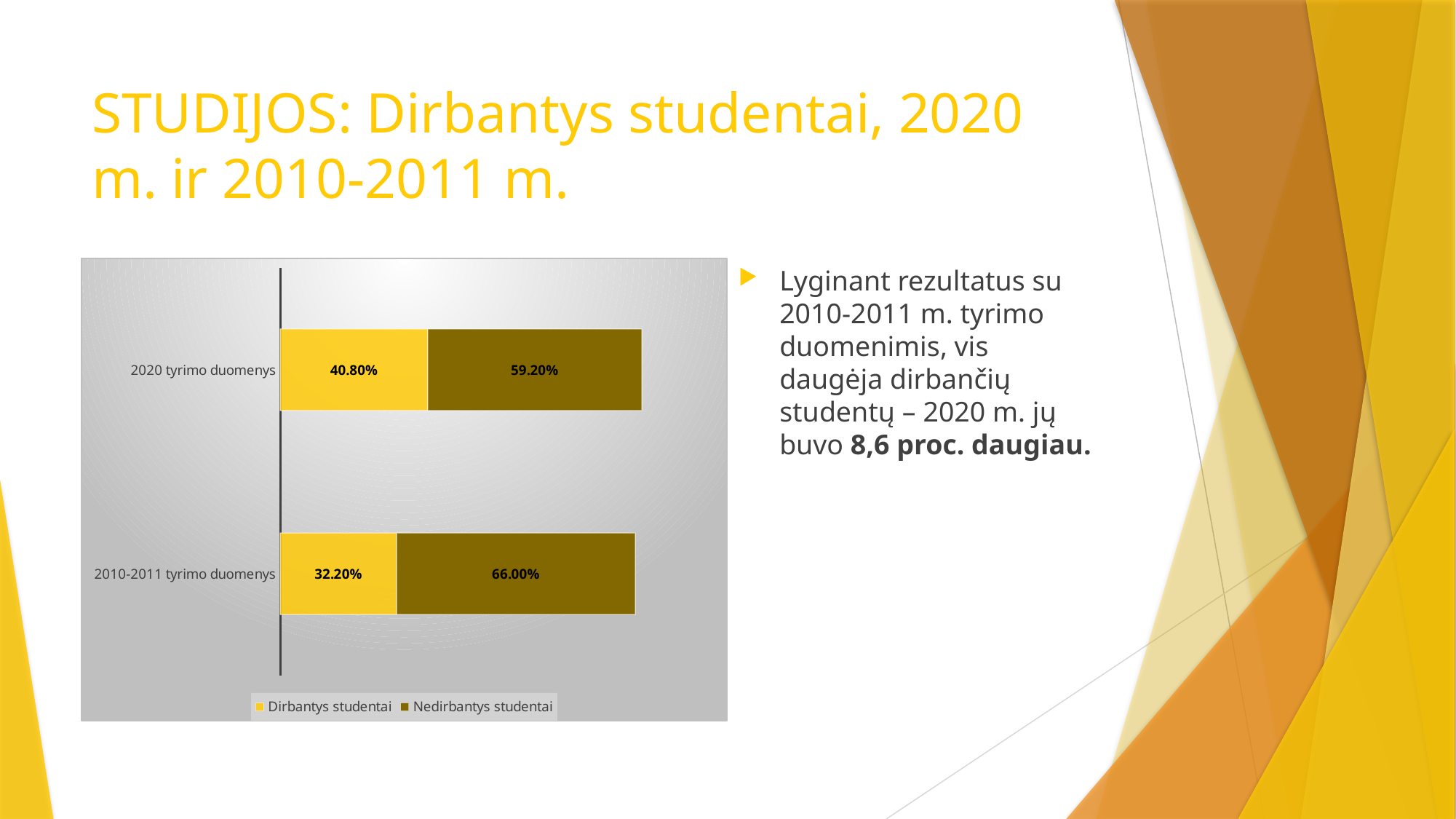
Which category has the higher value for Dirbantys studentai? 2020 tyrimo duomenys Which category has the lower value for Nedirbantys studentai? 2020 tyrimo duomenys What is the value for Dirbantys studentai in 2010-2011 tyrimo duomenys? 32.20% How many series does the legend list? 2 What is the value for Dirbantys studentai in 2020 tyrimo duomenys? 40.80% How many categories are shown on the chart? 2 What is the total of the stacked bar for 2010-2011 tyrimo duomenys? 98.20% Which is larger in 2020 tyrimo duomenys: Dirbantys studentai or Nedirbantys studentai? Nedirbantys studentai What is the value for Nedirbantys studentai in 2020 tyrimo duomenys? 59.20% What is the value for Nedirbantys studentai in 2010-2011 tyrimo duomenys? 66.00% What is the difference between the Dirbantys studentai values for 2020 tyrimo duomenys and 2010-2011 tyrimo duomenys? 8.60% What kind of chart is shown on the slide? Stacked bar chart